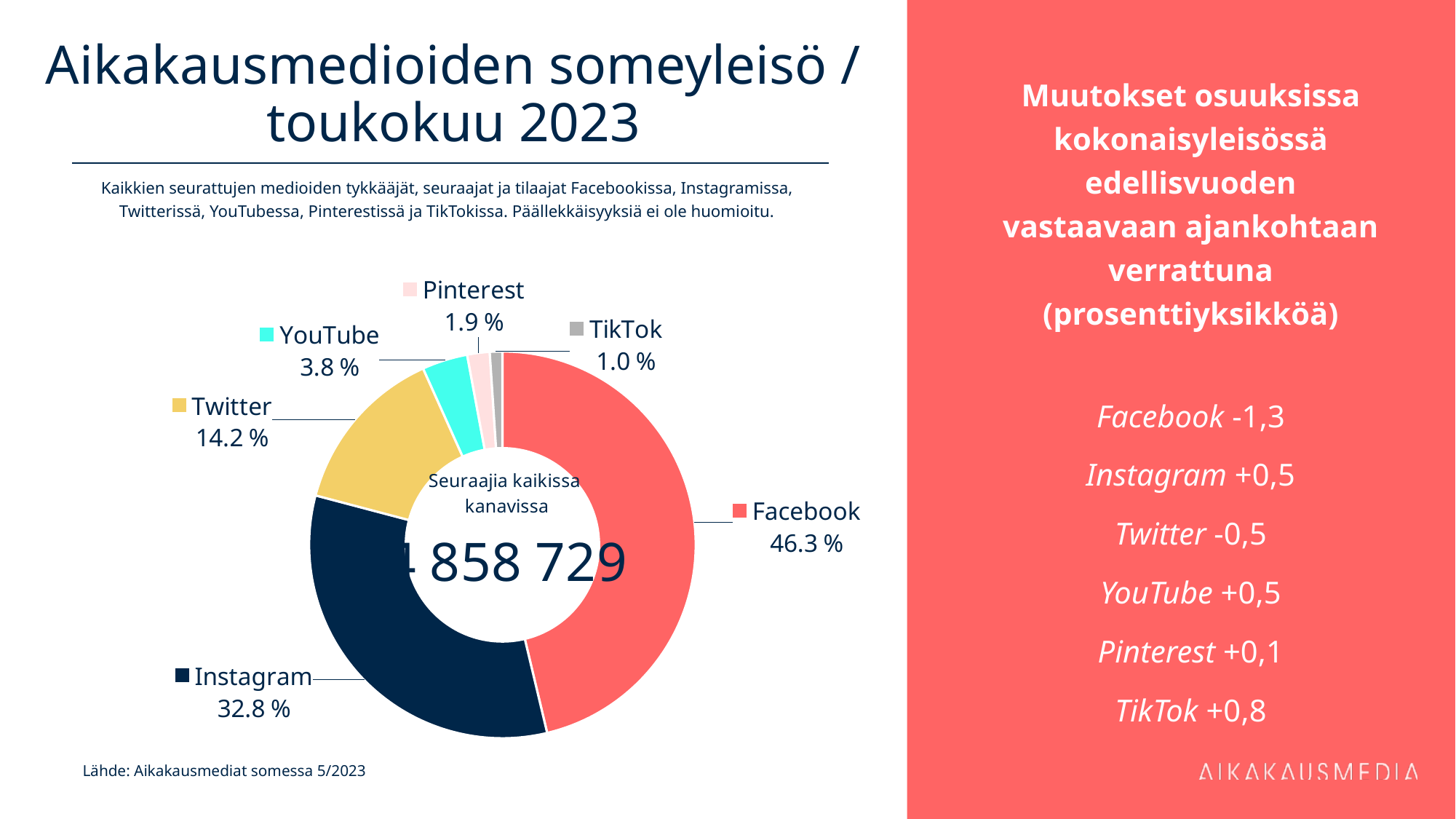
What type of chart is shown on the slide? Doughnut (pie) chart Which channel has the largest share in the doughnut chart? Facebook How many channels are shown in the doughnut chart? 6 Which has a larger share, Twitter or YouTube? Twitter What share of the doughnut chart does Twitter hold? 14.2 % What colour is the Twitter segment in the doughnut chart? Yellow What is the difference in percentage points between Facebook's and Instagram's shares? 13.5 What share of the doughnut chart does Instagram hold? 32.8 % What share of the doughnut chart does TikTok hold? 1.0 % What share of the doughnut chart does Facebook hold? 46.3 % What share of the doughnut chart does YouTube hold? 3.8 % Which channel has the smallest share in the doughnut chart? TikTok